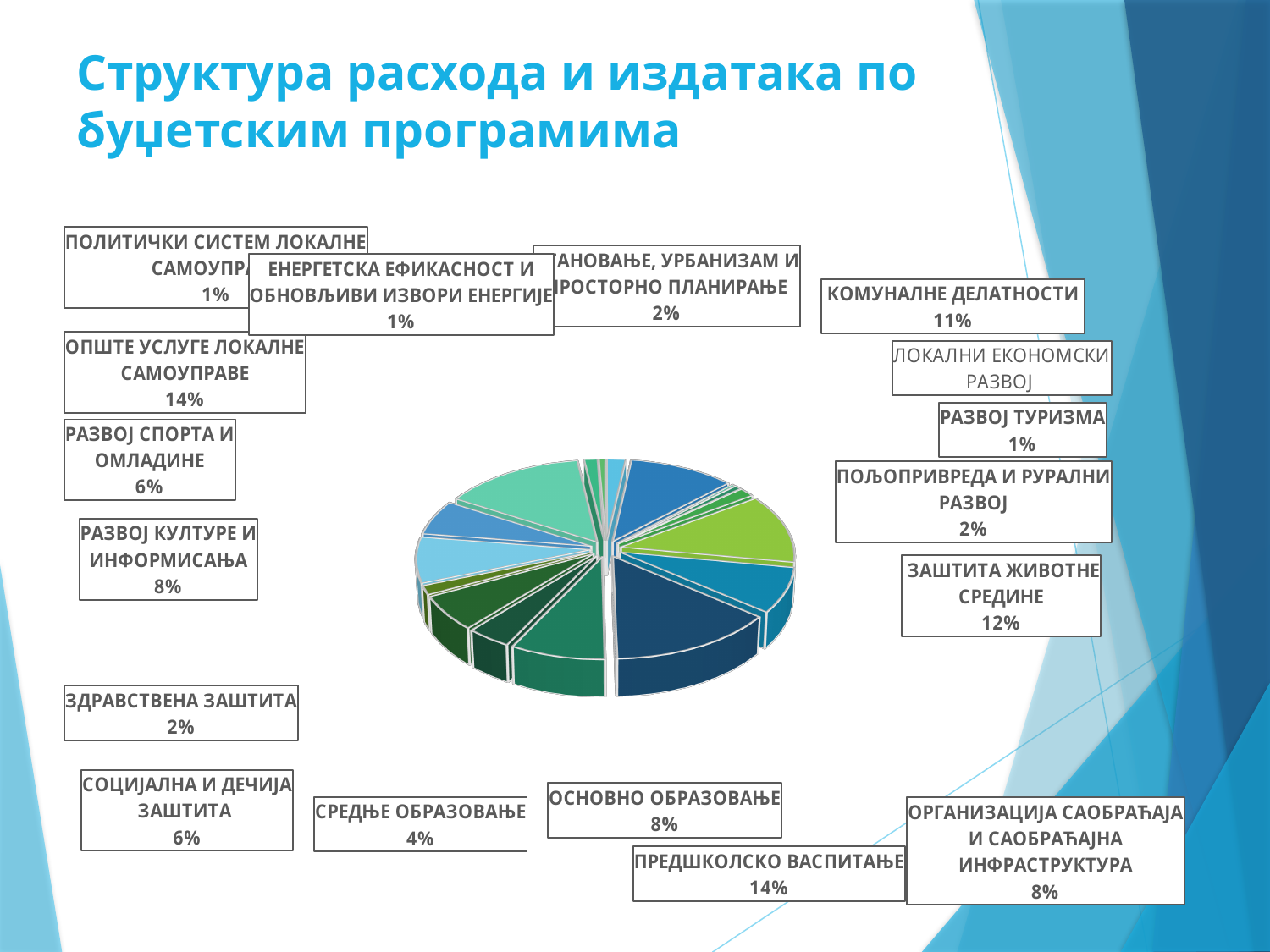
Which has a larger share: РАЗВОЈ КУЛТУРЕ И ИНФОРМИСАЊА or РАЗВОЈ СПОРТА И ОМЛАДИНЕ? РАЗВОЈ КУЛТУРЕ И ИНФОРМИСАЊА What share does РАЗВОЈ ТУРИЗМА have in the pie chart? 1% What share does КОМУНАЛНЕ ДЕЛАТНОСТИ have in the pie chart? 11% What share does СРЕДЊЕ ОБРАЗОВАЊЕ have in the pie chart? 4% What share does ЗАШТИТА ЖИВОТНЕ СРЕДИНЕ have in the pie chart? 12% What is the title of the slide? Структура расхода и издатака по буџетским програмима What share does ОПШТЕ УСЛУГЕ ЛОКАЛНЕ САМОУПРАВЕ have in the pie chart? 14% What type of chart is shown on the slide? pie chart What is the difference in percentage points between ПРЕДШКОЛСКО ВАСПИТАЊЕ and ОСНОВНО ОБРАЗОВАЊЕ? 6% What is the difference in percentage points between СОЦИЈАЛНА И ДЕЧИЈА ЗАШТИТА and ЗДРАВСТВЕНА ЗАШТИТА? 4% What share does ПРЕДШКОЛСКО ВАСПИТАЊЕ have in the pie chart? 14% Which has a larger share: ЗАШТИТА ЖИВОТНЕ СРЕДИНЕ or КОМУНАЛНЕ ДЕЛАТНОСТИ? ЗАШТИТА ЖИВОТНЕ СРЕДИНЕ